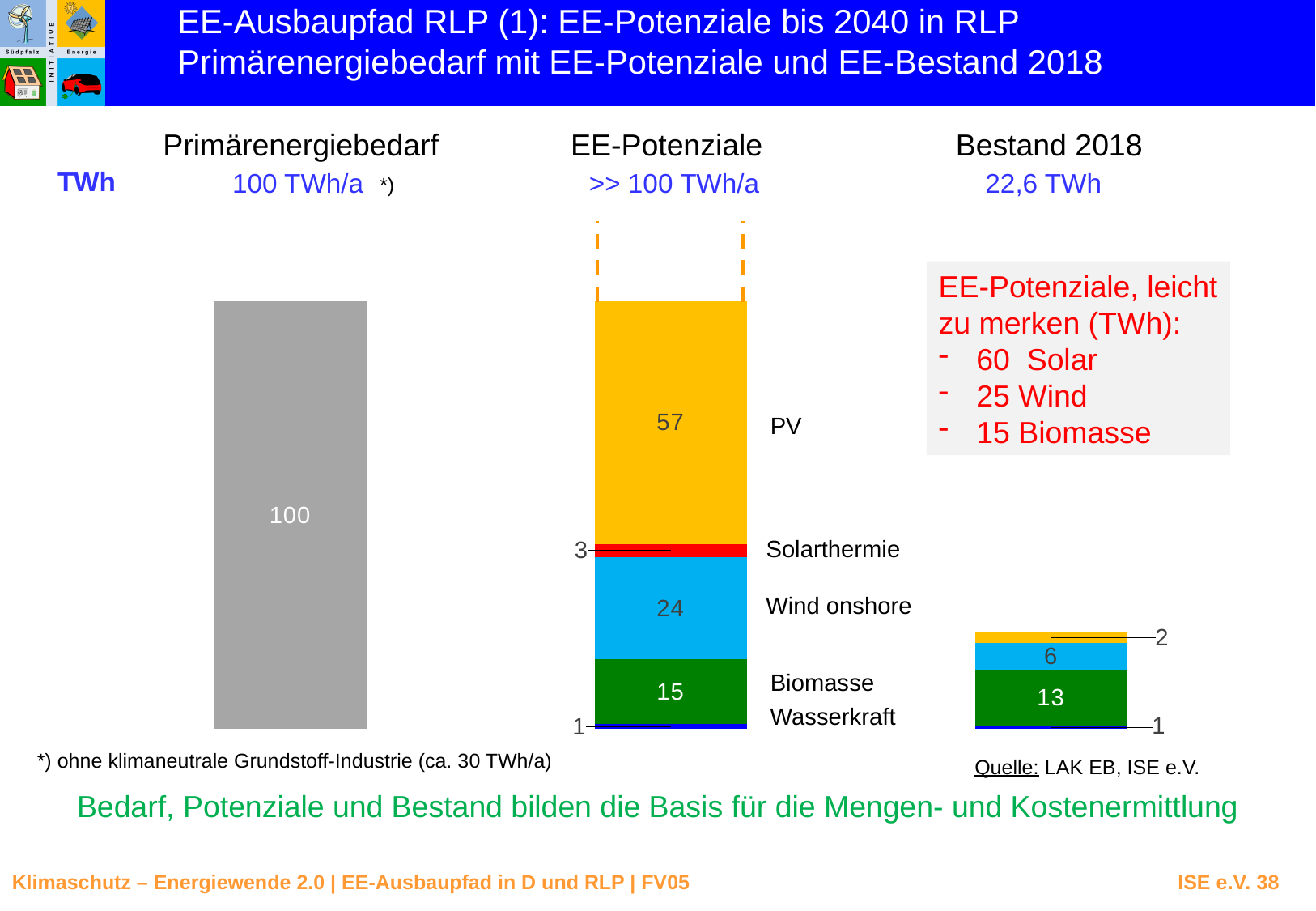
In the EE-Potenziale bar, what is the value for Biomasse? 15 What value is shown on the Primärenergiebedarf bar? 100 In the EE-Potenziale bar, what is the value for Wasserkraft? 1 What is the total of the EE-Potenziale stacked bar (PV, Solarthermie, Wind onshore, Biomasse, Wasserkraft)? 100 In the EE-Potenziale bar, what is the value for Wind onshore? 24 Which segment of the EE-Potenziale bar is the largest? PV In the Bestand 2018 bar, what is the value of the green (Biomasse) segment? 13 In the EE-Potenziale bar, what is the difference between the PV value and the Wind onshore value? 33 In the EE-Potenziale bar, what is the value for Solarthermie? 3 In the EE-Potenziale bar, what is the value for PV? 57 What total is given for Bestand 2018 above its bar? 22,6 TWh Which segment of the EE-Potenziale bar is the smallest? Wasserkraft